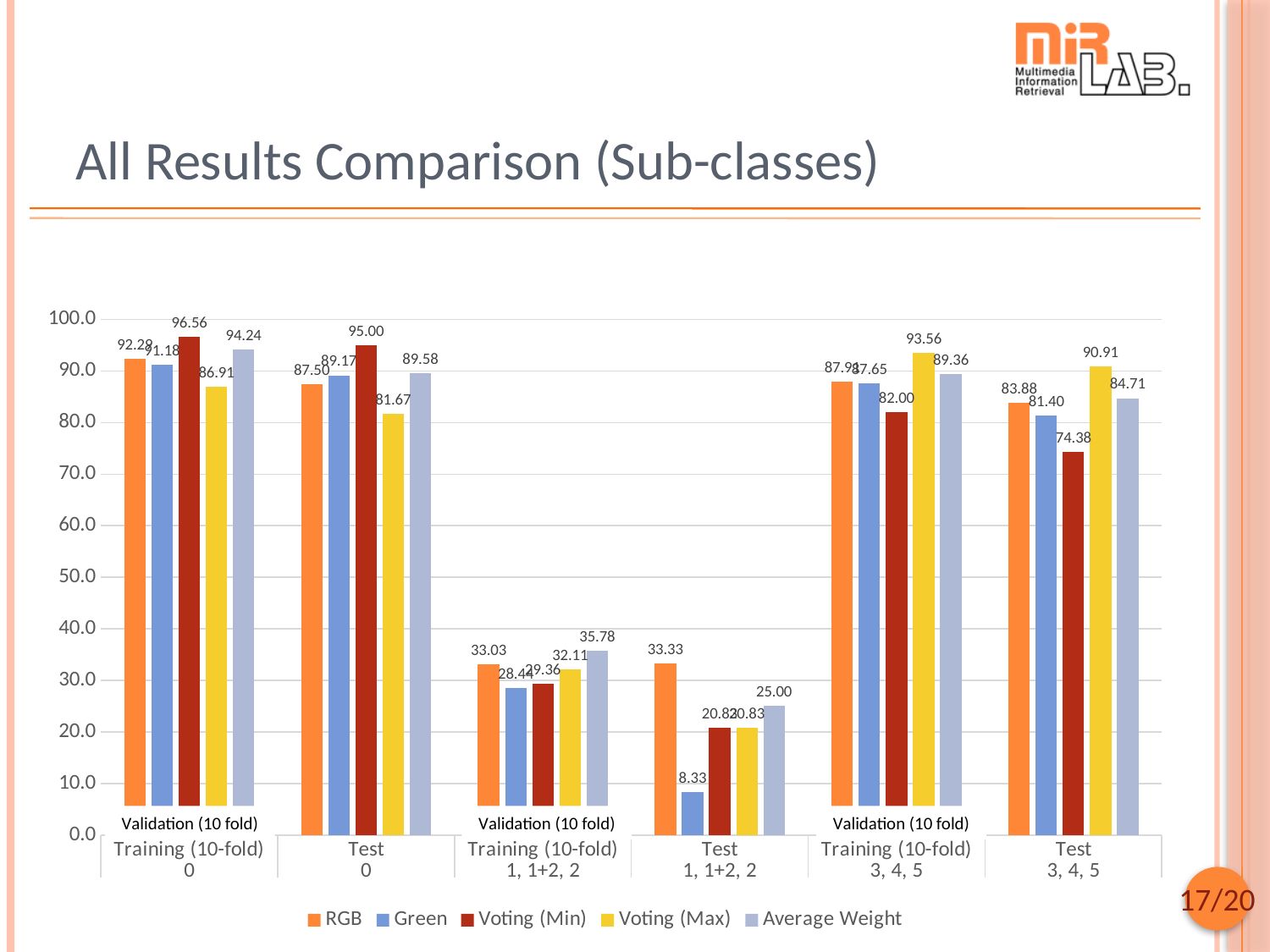
Which series has the lowest value in the Test 3, 4, 5 group? Voting (Min) What is the value of Voting (Max) for Test 3, 4, 5? 90.91 What type of chart is shown on the slide? bar chart How many category groups are shown along the x axis? 6 Is the value of RGB for Test 1, 1+2, 2 greater or less than 30.0? greater What is the value of Average Weight for Training (10-fold) 1, 1+2, 2? 35.78 What is the value of Green for Test 1, 1+2, 2? 8.33 What is the value of Voting (Min) for Test 0? 95.00 What is the difference between Voting (Max) and Voting (Min) in the Training (10-fold) 3, 4, 5 group? 11.56 Which series has the highest value in the Training (10-fold) 0 group? Voting (Min) Which is larger in the Test 0 group: RGB or Green? Green How many series does the legend list? 5